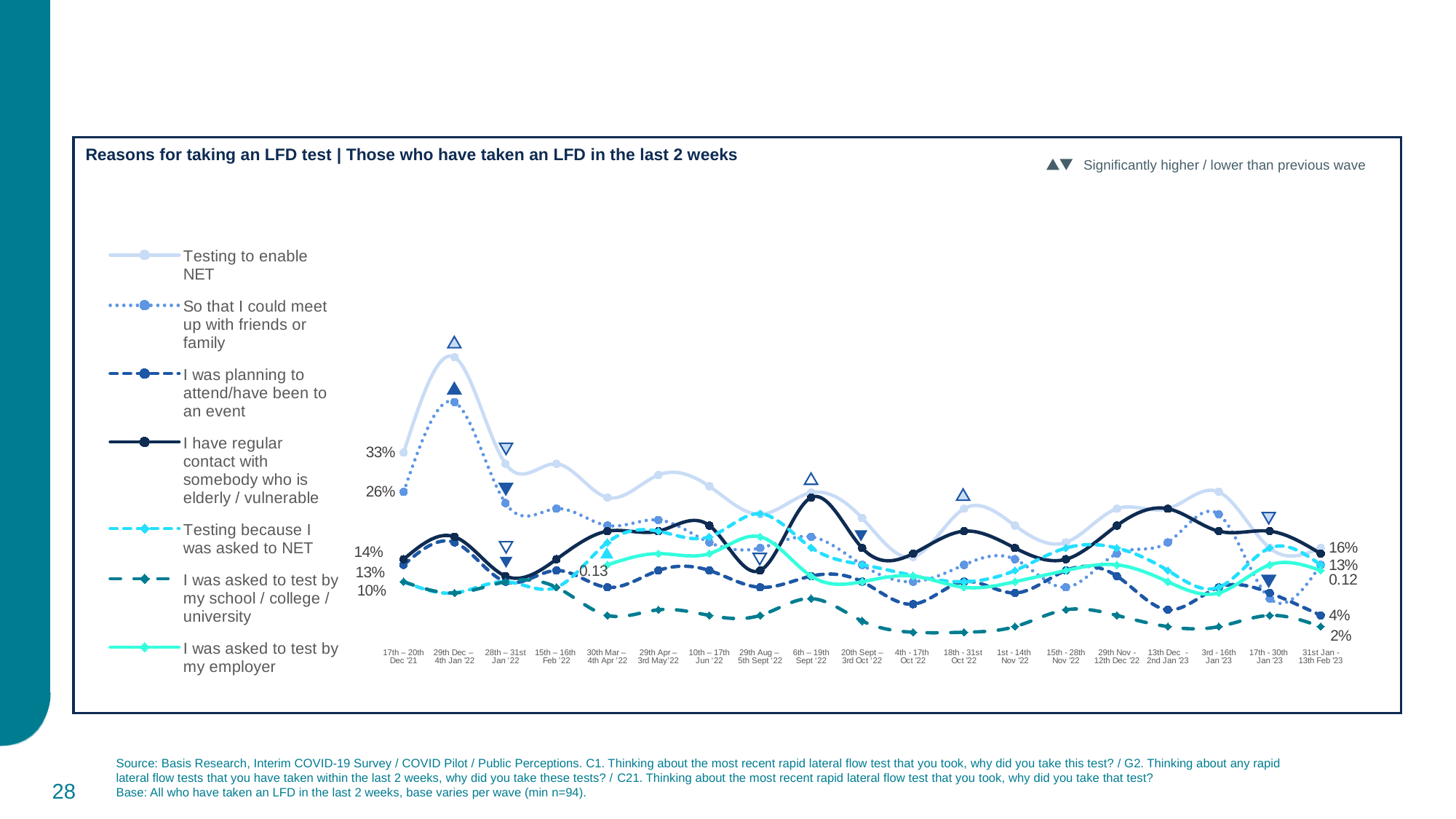
According to the key at the top right, what do the triangle markers on the chart indicate? Significantly higher / lower than previous wave What is the value for 'I was asked to test by my school / college / university' in the 31st Jan - 13th Feb '23 wave? 2% Which series has the lowest value in the 31st Jan - 13th Feb '23 wave? I was asked to test by my school / college / university Which series has the highest value in the 17th – 20th Dec '21 wave? Testing to enable NET What is the value for 'So that I could meet up with friends or family' in the 17th – 20th Dec '21 wave? 26% Does the 'Testing to enable NET' line rise or fall overall from the first wave to the last wave? Fall How many survey waves are shown along the x axis? 19 How many series does the legend list? 7 What kind of chart is shown on the slide? Line chart In the 17th – 20th Dec '21 wave, how much higher is 'Testing to enable NET' than 'So that I could meet up with friends or family'? 7 percentage points What is the value for 'Testing to enable NET' in the 17th – 20th Dec '21 wave? 33%